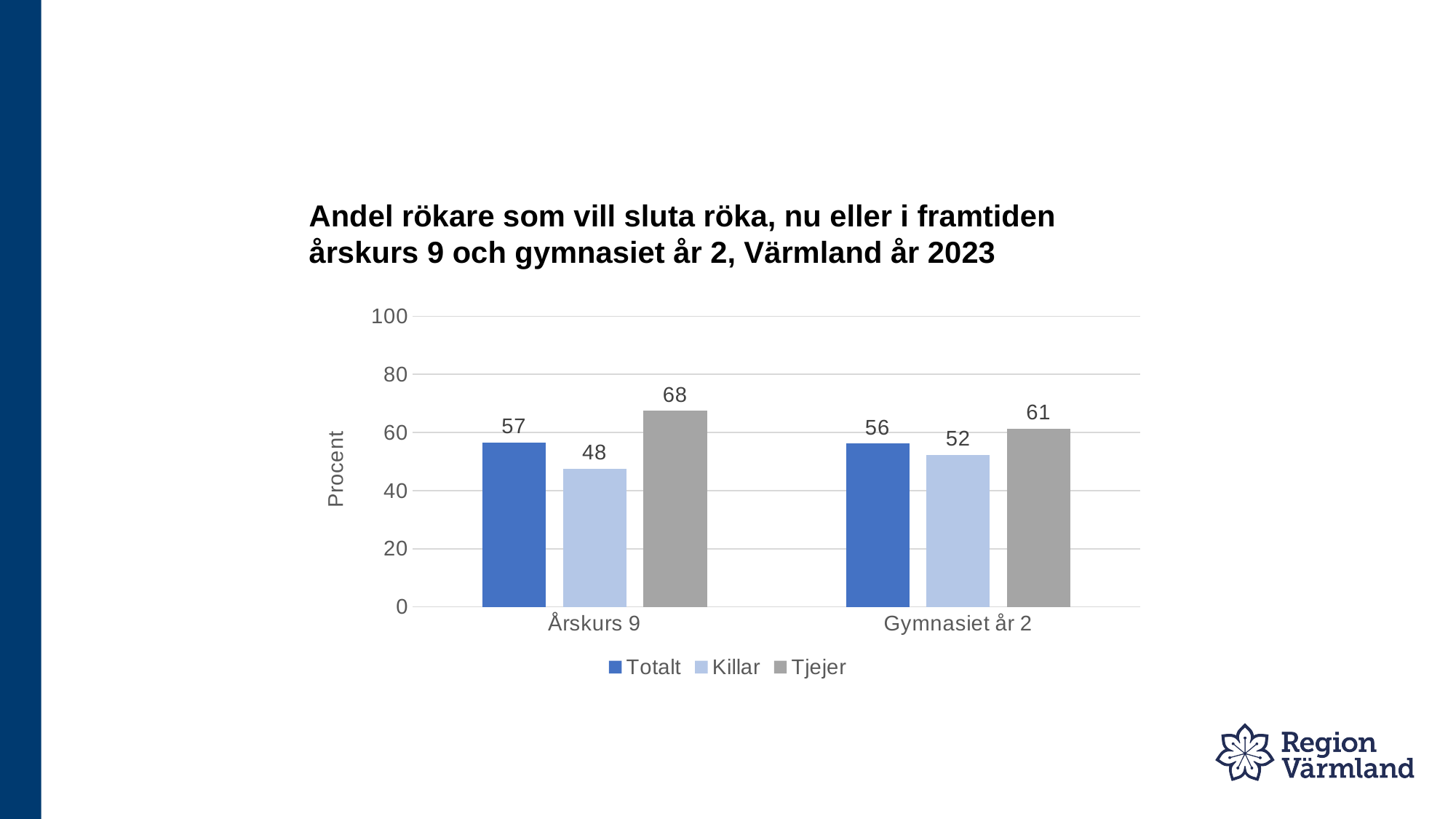
How many series does the legend list? 3 What is the value for Totalt in Årskurs 9? 57 What is the value for Tjejer in Årskurs 9? 68 What kind of chart is shown on the slide? Bar chart Which series has the highest value in Gymnasiet år 2? Tjejer What is the difference between Tjejer in Årskurs 9 and Tjejer in Gymnasiet år 2? 7 What is the value for Killar in Gymnasiet år 2? 52 How many categories are shown on the x axis? 2 What is the difference between Tjejer and Killar in Årskurs 9? 20 Which is larger: Killar in Årskurs 9 or Killar in Gymnasiet år 2? Killar in Gymnasiet år 2 Which series has the lowest value in Årskurs 9? Killar What is the label of the y axis? Procent